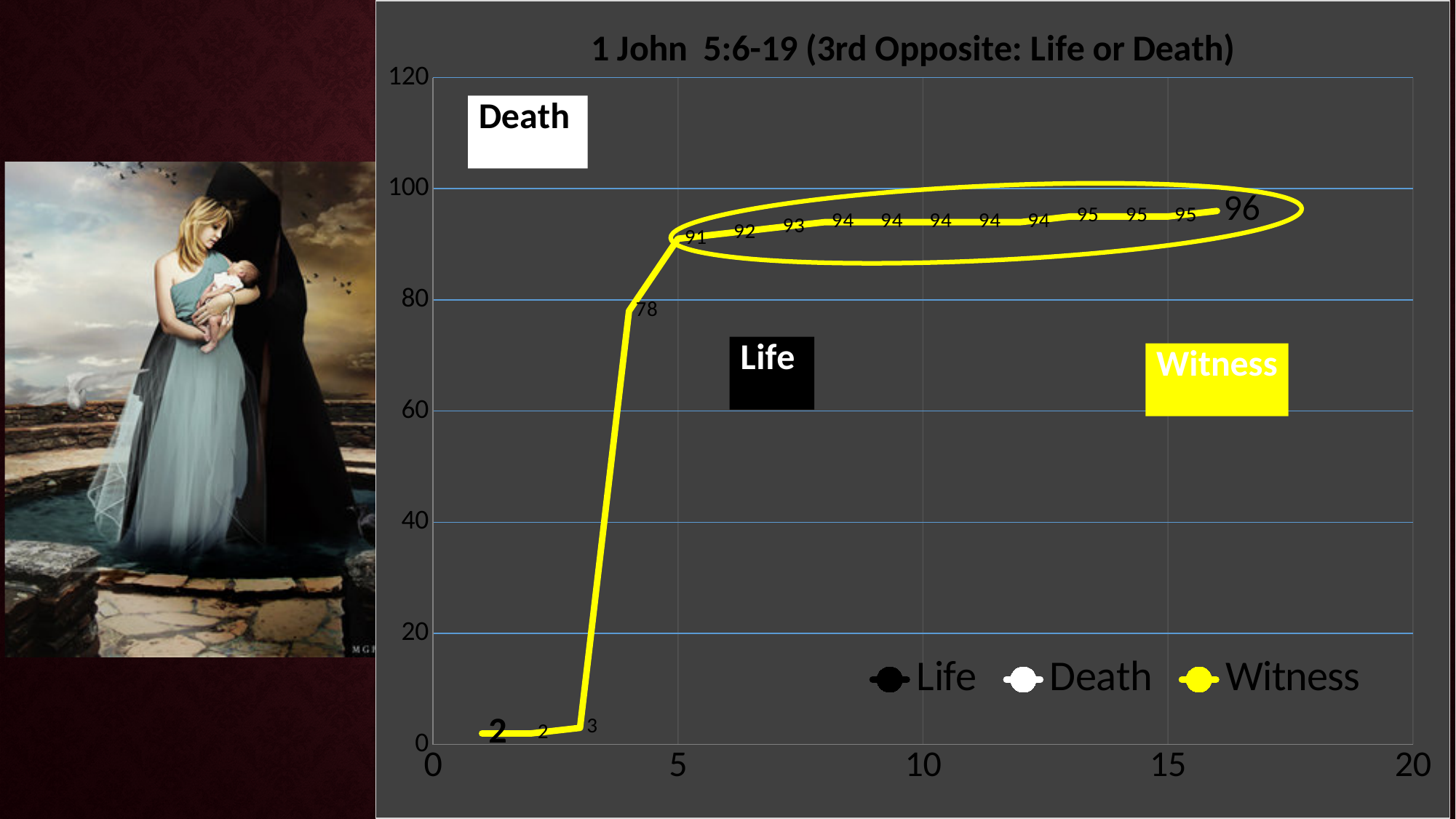
What is the value of the Witness line at x = 4? 78 What is the value of the Witness line at x = 5? 91 Is the Witness value at x = 4 greater or less than 80? less Do the values of the Witness line generally rise or fall as x increases? rise Which is larger, the Witness value at x = 4 or at x = 5? x = 5 What kind of chart is shown on the slide? line chart What is the lowest data label shown on the Witness line? 2 How many series does the chart legend list? 3 What is the difference between the last labelled value (96) and the first labelled value (2) on the Witness line? 94 What is the title of the chart? 1 John 5:6-19 (3rd Opposite: Life or Death) What is the highest data label shown on the Witness line? 96 How many data points are labelled on the Witness line? 16